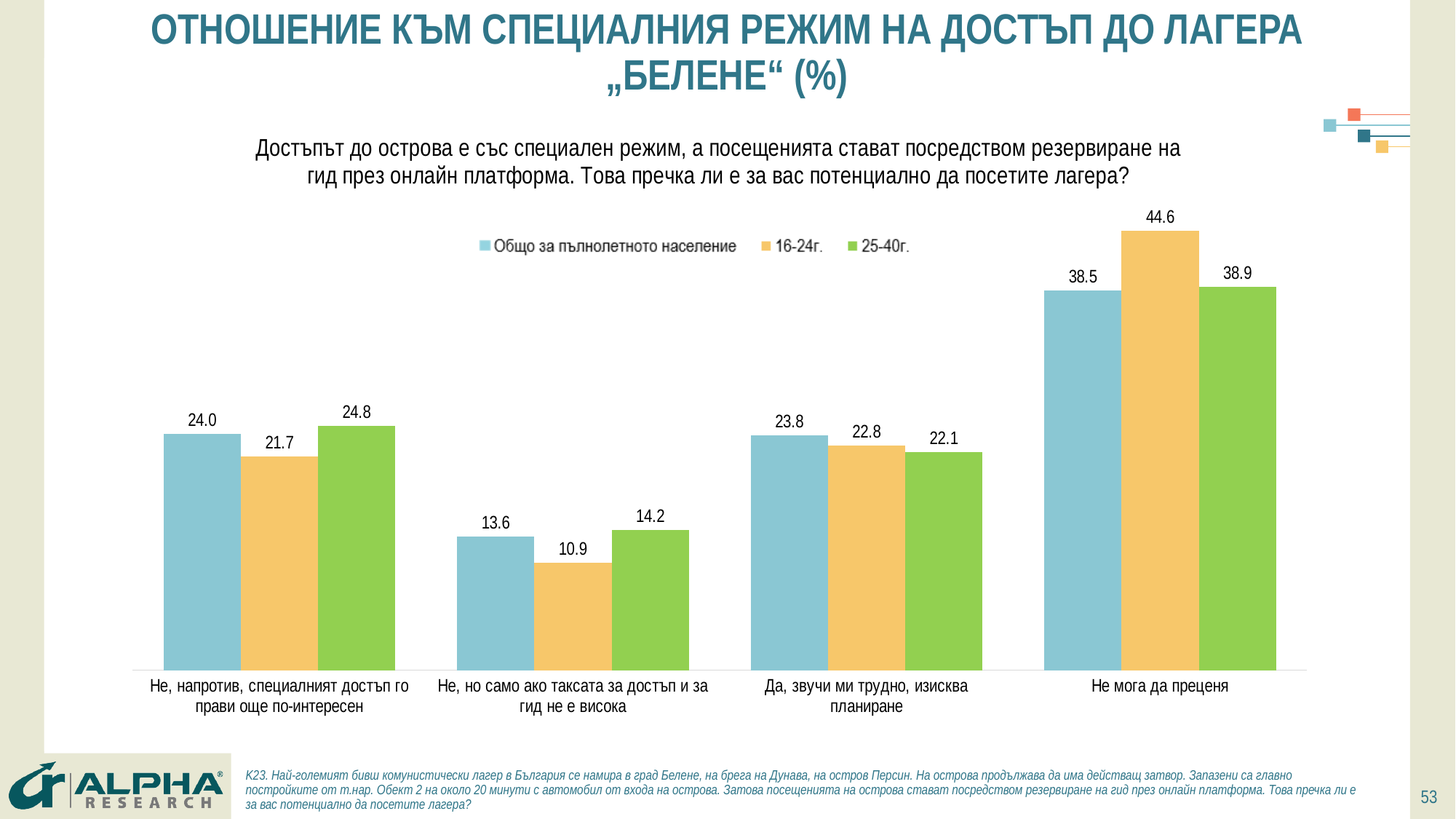
What is the value for "Общо за пълнолетното население" in the category "Да, звучи ми трудно, изисква планиране"? 23.8 In the category "Да, звучи ми трудно, изисква планиране", which series has the larger value: "16-24г." or "25-40г."? 16-24г. What is the value for the "16-24г." series in the category "Не, но само ако таксата за достъп и за гид не е висока"? 10.9 How many series does the legend list? 3 How many categories are shown on the x axis? 4 What is the difference between the "16-24г." and "25-40г." values in the category "Не мога да преценя"? 5.7 What is the value for the "25-40г." series in the category "Не, напротив, специалният достъп го прави още по-интересен"? 24.8 What is the value for "Общо за пълнолетното население" in the category "Не мога да преценя"? 38.5 Which colour represents the "25-40г." series in the legend? Green What kind of chart is shown on the slide? Bar chart Which category has the lowest value for "Общо за пълнолетното население"? Не, но само ако таксата за достъп и за гид не е висока Which category has the highest value for the "16-24г." series? Не мога да преценя